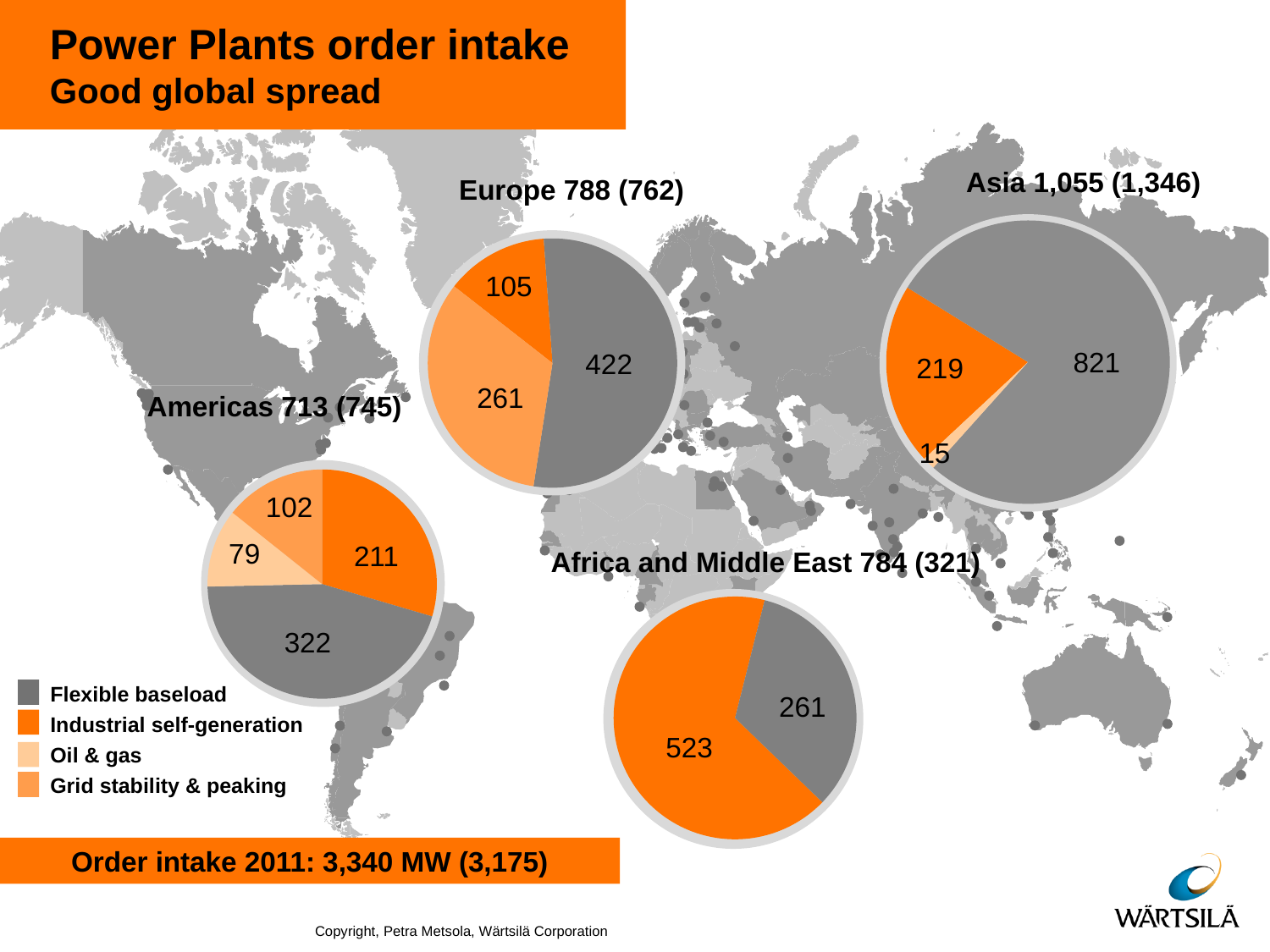
In the Europe pie chart, what is the difference between Flexible baseload and Grid stability & peaking? 161 How many slices does the Americas pie chart have? 4 In the Europe pie chart, what is the value for Flexible baseload? 422 How many categories does the legend list? 4 What kind of charts are shown on the slide? Pie charts In the Americas pie chart, what is the value for Oil & gas? 79 In the Africa and Middle East pie chart, what is the value for Industrial self-generation? 523 Which region's pie chart has the largest total order intake shown in its title? Asia In the Africa and Middle East pie chart, which is larger, Industrial self-generation or Flexible baseload? Industrial self-generation In the Asia pie chart, which category has the smallest value? Oil & gas In the Asia pie chart, what is the value for Industrial self-generation? 219 In the Americas pie chart, which category has the largest value? Flexible baseload